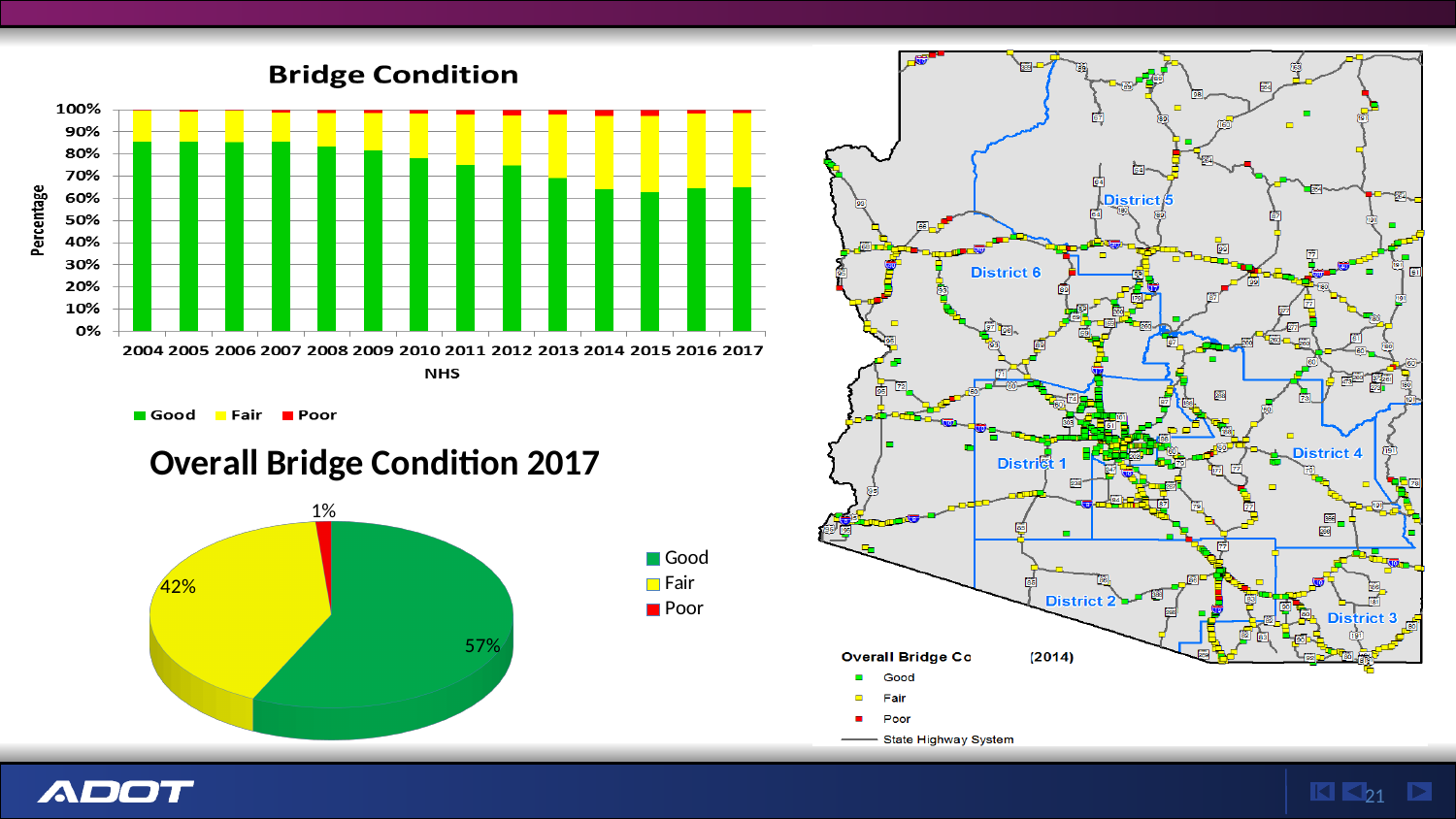
In the 'Bridge Condition' bar chart, is the Good percentage for 2004 greater or less than 80%? greater In the 'Bridge Condition' bar chart, is the Good percentage for 2017 greater or less than 70%? less In the 'Overall Bridge Condition 2017' pie chart, what percentage of bridges are in Good condition? 57% In the 'Overall Bridge Condition 2017' pie chart, what percentage of bridges are in Poor condition? 1% In the 'Overall Bridge Condition 2017' pie chart, which condition category has the smallest share? Poor In the 'Overall Bridge Condition 2017' pie chart, what percentage of bridges are in Fair condition? 42% In the 'Overall Bridge Condition 2017' pie chart, which condition category has the largest share? Good How many years are shown on the x axis of the 'Bridge Condition' bar chart? 14 In the 'Bridge Condition' bar chart, does the Good percentage generally rise or fall from 2004 to 2017? fall What kind of chart is the 'Bridge Condition' chart at the top left of the slide? Stacked bar chart How many series does the legend of the 'Bridge Condition' bar chart list? 3 In the 'Overall Bridge Condition 2017' pie chart, how many percentage points larger is the Good share than the Fair share? 15 percentage points